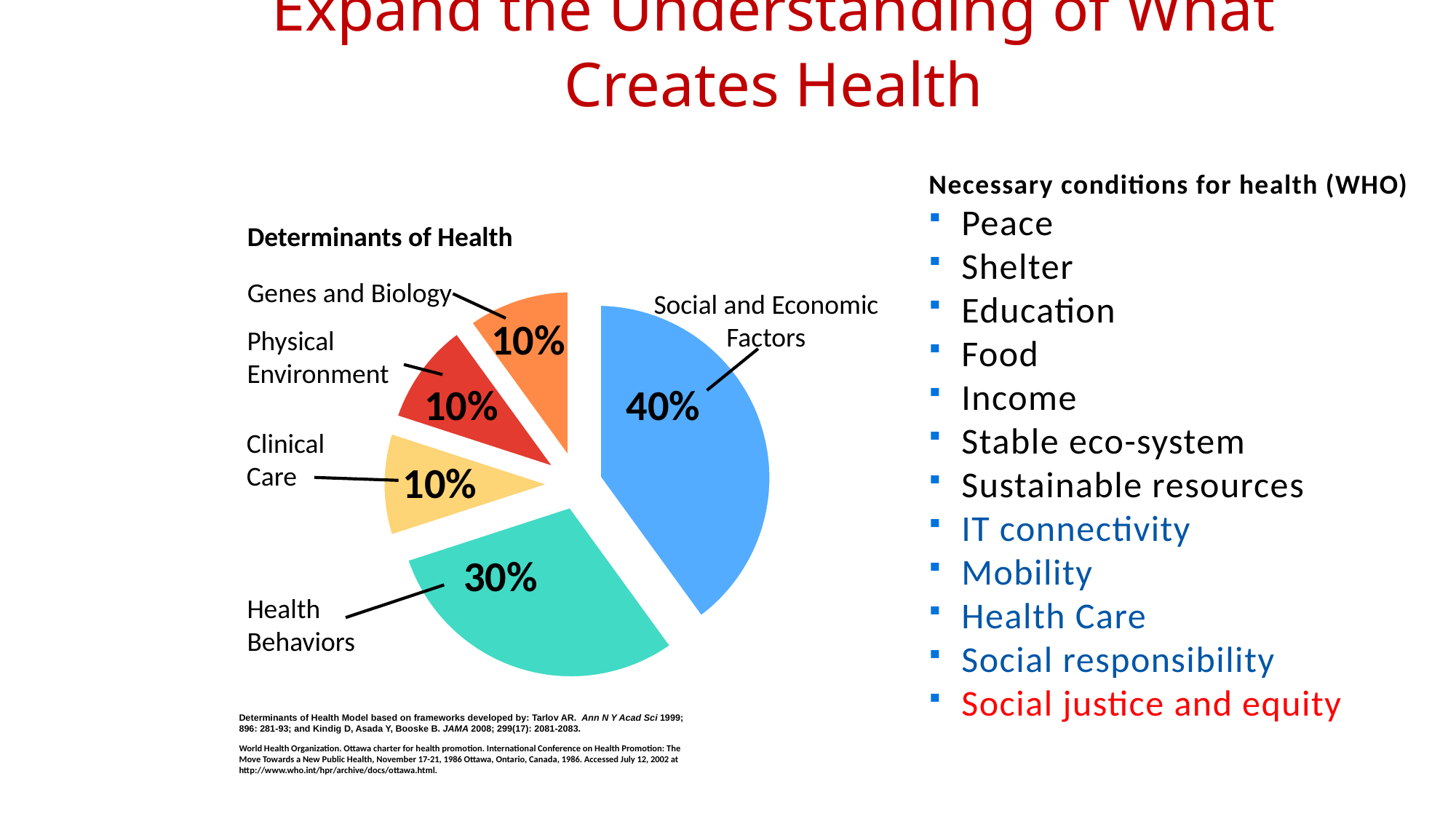
Which category has the largest slice of the pie? Social and Economic Factors What colour is the Social and Economic Factors slice? blue What share of the pie is Social and Economic Factors? 40% What share of the pie is Clinical Care? 10% What is the title of the chart? Determinants of Health What share of the pie is Health Behaviors? 30% What share of the pie is Genes and Biology? 10% What is the difference between the Social and Economic Factors slice and the Health Behaviors slice? 10% What share of the pie is Physical Environment? 10% What kind of chart is shown on the slide? pie chart How many slices does the pie chart have? 5 Which is larger, the Health Behaviors slice or the Clinical Care slice? Health Behaviors